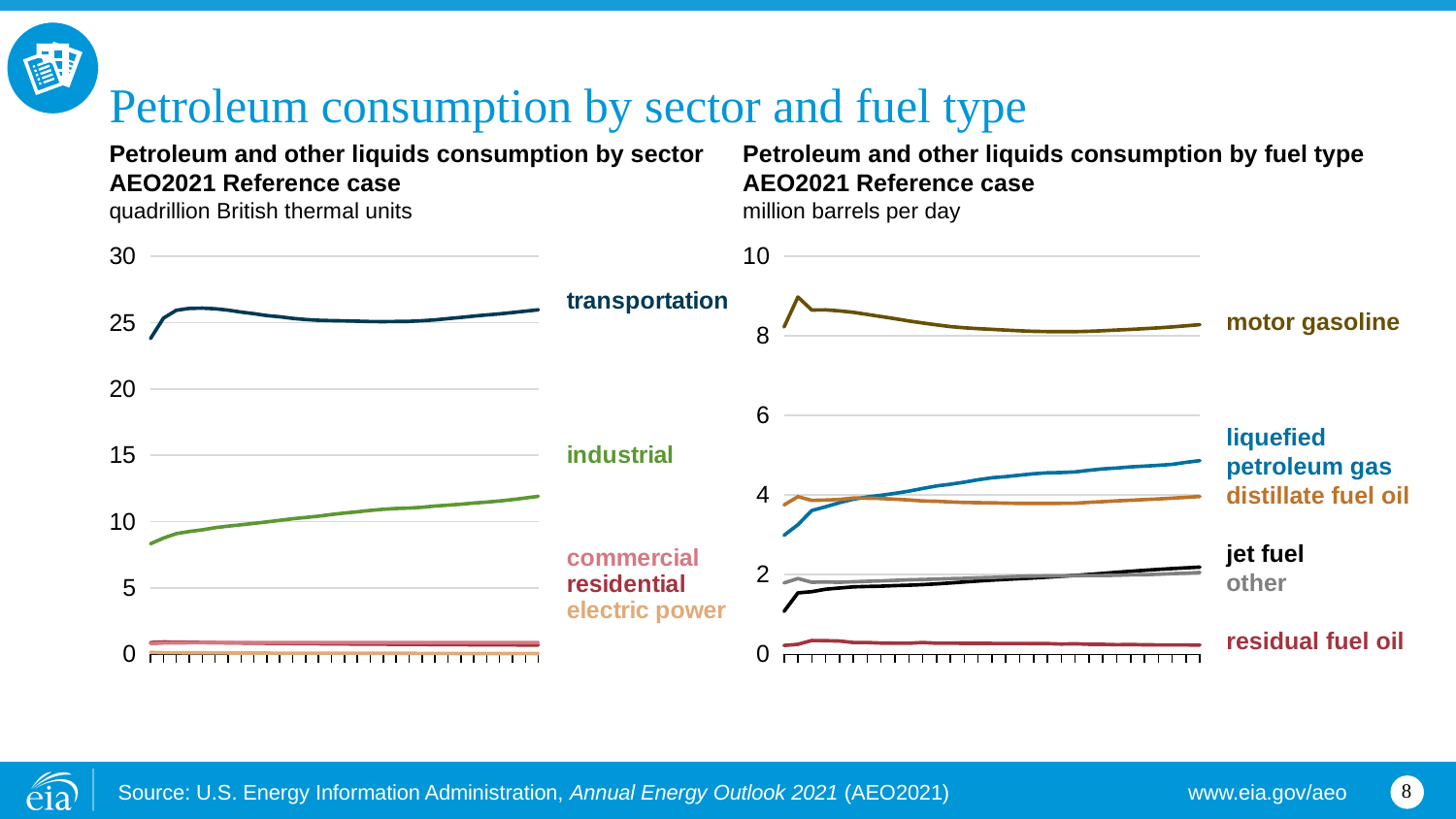
What kind of chart is the 'Petroleum and other liquids consumption by sector' chart on the left? line chart In the right chart (consumption by fuel type), is the value for motor gasoline greater or less than 6 million barrels per day throughout the period? greater In the left chart (consumption by sector), how many sectors are plotted? 5 In the left chart (consumption by sector), does industrial consumption rise or fall over the period? rise In the right chart (consumption by fuel type), which fuel type has the highest consumption? motor gasoline In the left chart (consumption by sector), which sector has the highest consumption? transportation In the left chart (consumption by sector), is the value for industrial greater or less than 15 quadrillion British thermal units throughout the period? less What unit is used on the right chart (consumption by fuel type)? million barrels per day In the right chart (consumption by fuel type), which fuel type has the lowest consumption? residual fuel oil In the left chart (consumption by sector), is the value for transportation greater or less than 20 quadrillion British thermal units throughout the period? greater In the right chart (consumption by fuel type), how many fuel types are plotted? 6 What kind of chart is the 'Petroleum and other liquids consumption by fuel type' chart on the right? line chart